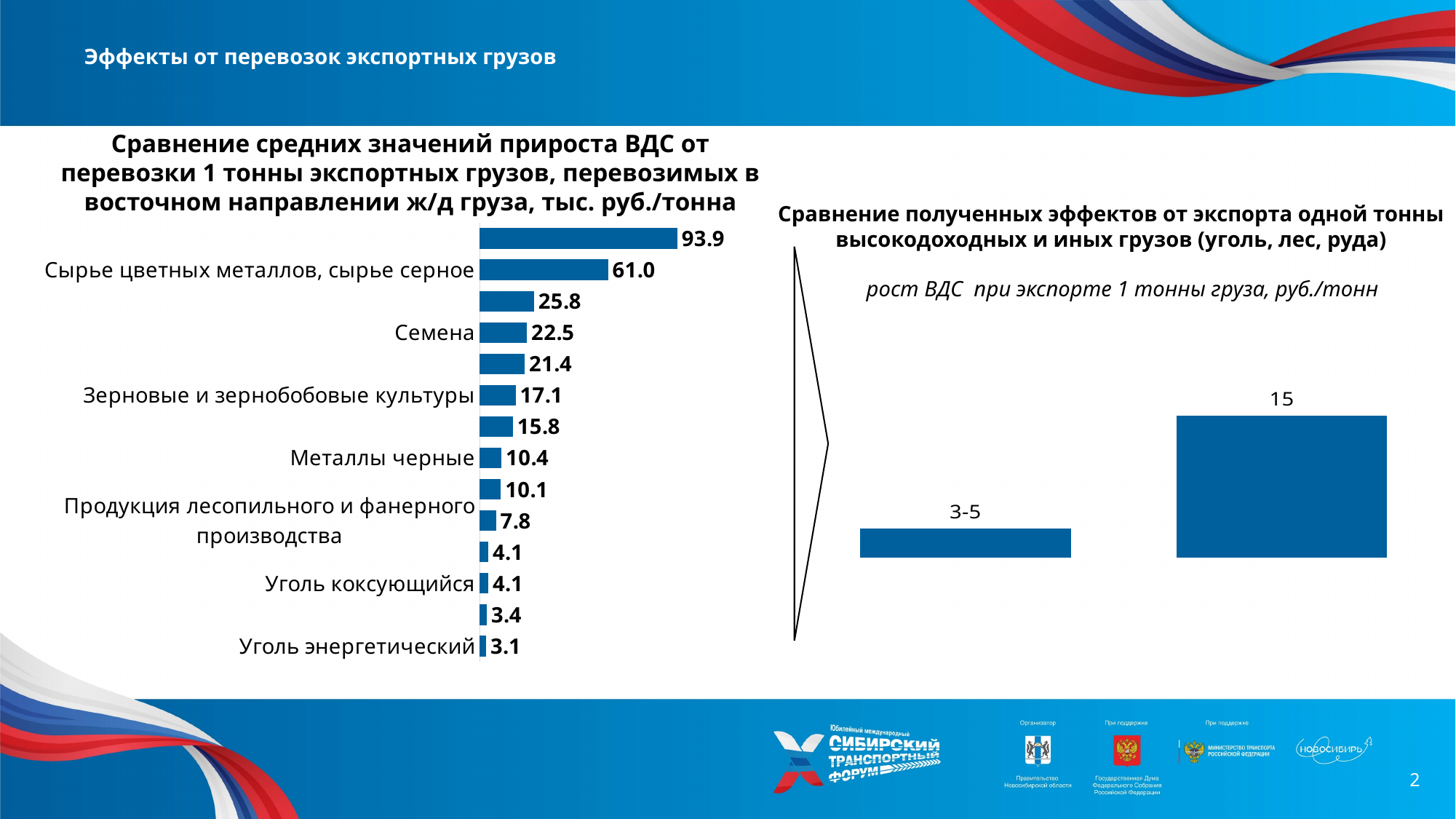
What type of chart is the left chart? Bar chart On the left chart, which is larger: the value for Металлы черные or the value for Продукция лесопильного и фанерного производства? Металлы черные On the left chart, what is the value for Уголь коксующийся? 4.1 On the left chart, what is the value for Сырье цветных металлов, сырье серное? 61.0 How many bars are plotted on the left chart? 14 On the right chart, what is the value labelled on the taller bar? 15 On the left chart, what is the value for Металлы черные? 10.4 On the left chart, what is the highest value shown on any bar? 93.9 On the left chart, what is the value for Семена? 22.5 On the left chart, what is the difference between the values for Семена and Зерновые и зернобобовые культуры? 5.4 On the left chart, which labelled category has the lowest value? Уголь энергетический How many bars are plotted on the right chart? 2